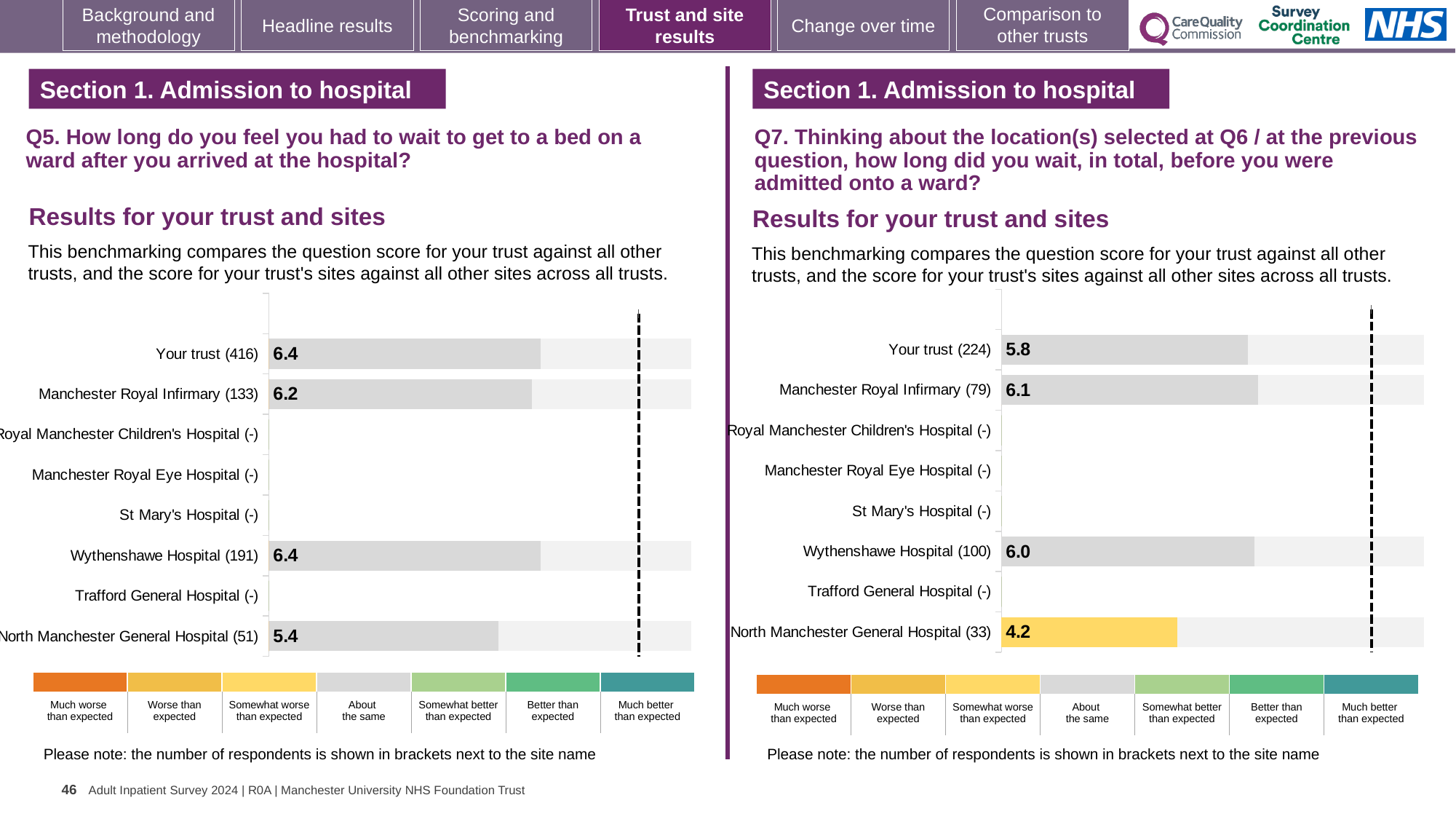
On the Q5 chart (left), what is the score for Manchester Royal Infirmary? 6.2 On the Q5 chart (left), what is the score for North Manchester General Hospital? 5.4 What type of chart is used on the Q5 chart (left)? Bar chart On the Q7 chart (right), which is larger: the score for Wythenshawe Hospital or the score for Your trust? Wythenshawe Hospital How many site/trust categories are listed on the Q7 chart (right)? 8 On the Q5 chart (left), what is the score for Your trust? 6.4 On the Q5 chart (left), what is the difference between the scores for Wythenshawe Hospital and North Manchester General Hospital? 1.0 On the Q7 chart (right), what is the score for Your trust? 5.8 On the Q5 chart (left), which site with a plotted score has the lowest score? North Manchester General Hospital On the Q7 chart (right), what is the difference between the scores for Manchester Royal Infirmary and North Manchester General Hospital? 1.9 On the Q7 chart (right), what is the score for North Manchester General Hospital? 4.2 On the Q7 chart (right), which site with a plotted score has the highest score? Manchester Royal Infirmary